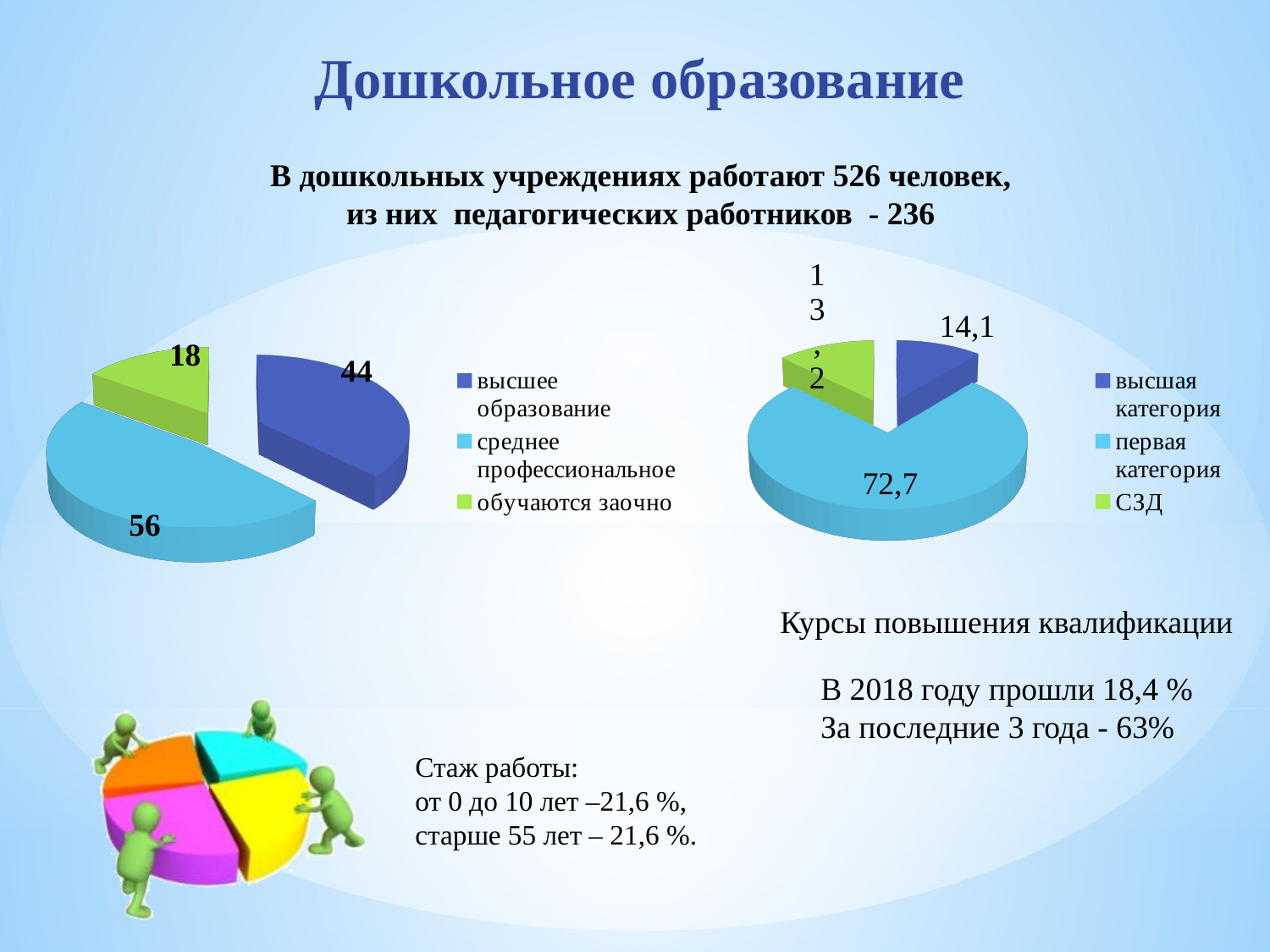
In the left pie chart, which category has the smallest value? обучаются заочно In the right pie chart, what is the value for "первая категория"? 72,7 How many entries does the legend of the right pie chart list? 3 In the left pie chart, which category has the largest value? среднее профессиональное What type of chart is the left chart on the slide? pie chart In the right pie chart, which is larger: "высшая категория" or "первая категория"? первая категория In the left pie chart, what is the value for "высшее образование"? 44 In the right pie chart, what is the value for "высшая категория"? 14,1 In the right pie chart, which category has the largest value? первая категория In the left pie chart, what is the value for "среднее профессиональное"? 56 In the left pie chart, what is the value for "обучаются заочно"? 18 In the left pie chart, what is the difference between the values for "среднее профессиональное" and "высшее образование"? 12